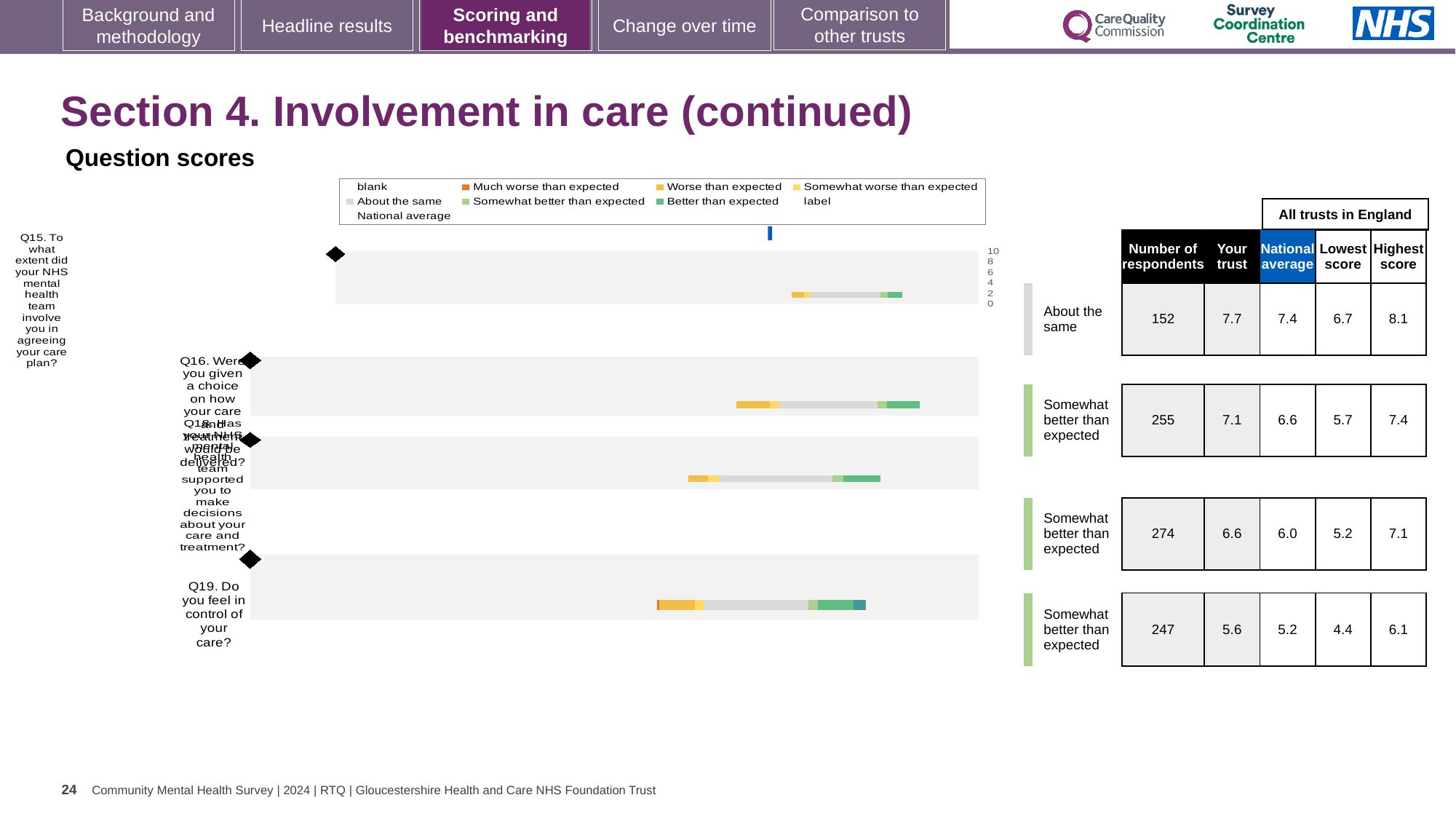
What is the highest score among all trusts in England for Q16 (Were you given a choice on how your care and treatment would be delivered?)? 7.4 What is the lowest score among all trusts in England for Q15? 6.7 What is the 'Your trust' score for Q15 (To what extent did your NHS mental health team involve you in agreeing your care plan?)? 7.7 For Q16, which is larger: the 'Your trust' score or the national average? Your trust Which question has the lowest 'Your trust' score? Q19 What benchmark category is shown next to Q15's bar? About the same How many respondents answered Q18 (Has your NHS mental health team supported you to make decisions about your care and treatment?)? 274 What kind of chart is used to show the question scores? Bar chart Which question has the highest 'Your trust' score? Q15 What is the difference between the 'Your trust' score and the national average for Q15? 0.3 What is the national average score for Q19 (Do you feel in control of your care?)? 5.2 How many questions are plotted in the question scores chart? 4